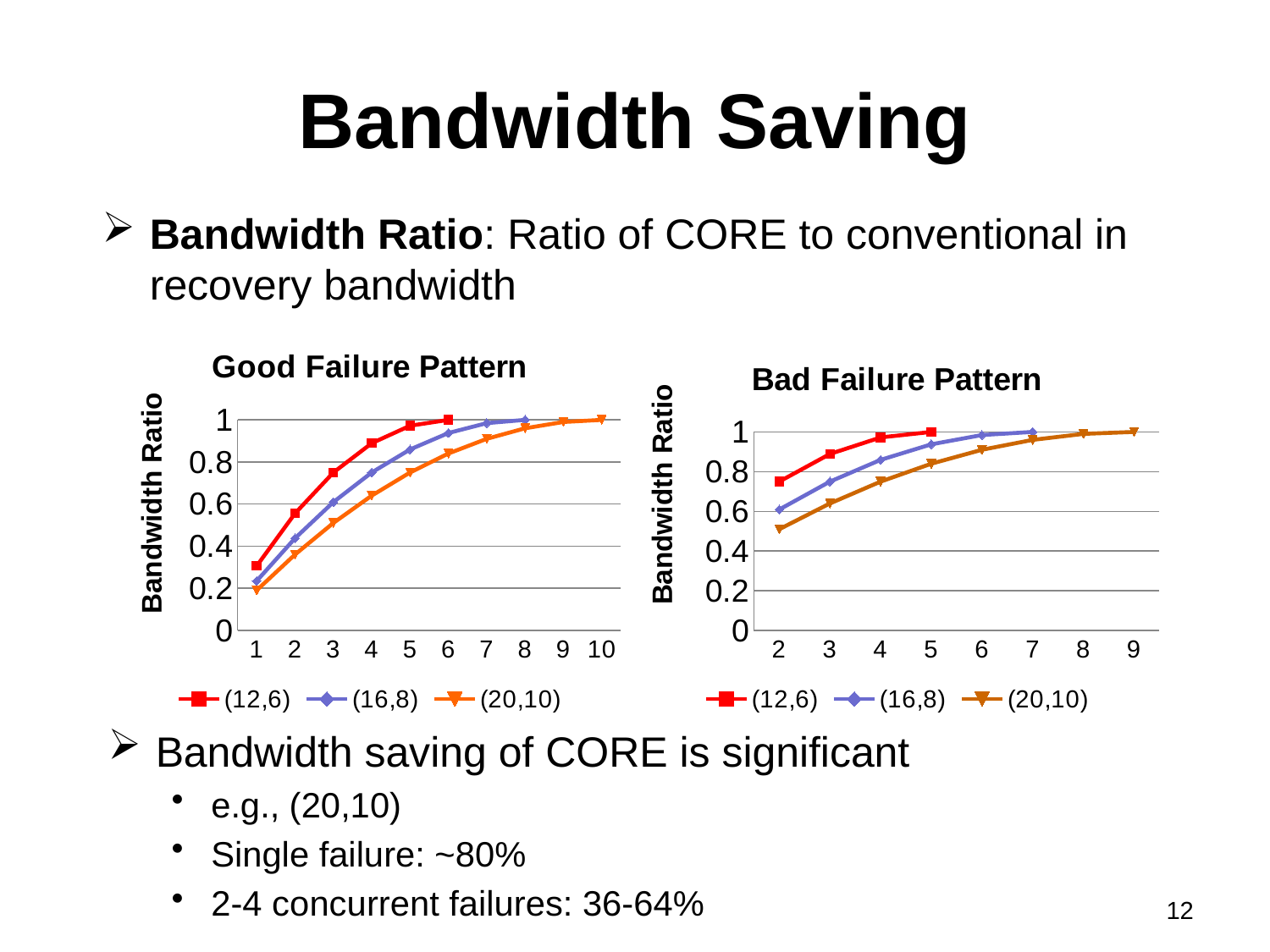
How many series does the legend of the Bad Failure Pattern chart list? 3 In the Bad Failure Pattern chart, is the value for (20,10) at x=2 greater or less than 0.6? less In the Good Failure Pattern chart, is the value for (20,10) at x=4 greater or less than 0.6? greater In the Good Failure Pattern chart, do the values for (16,8) rise or fall as x increases? rise In the Good Failure Pattern chart, which series has the highest value at x=3? (12,6) In the Bad Failure Pattern chart, which series has the lowest value at x=2? (20,10) What is the y-axis label of the Bad Failure Pattern chart? Bandwidth Ratio In the Good Failure Pattern chart, is the value for (12,6) at x=1 greater or less than 0.4? less What type of chart is the Good Failure Pattern chart? line chart In the Good Failure Pattern chart, how many points are on the x axis? 10 In the Bad Failure Pattern chart, how many points are on the x axis? 8